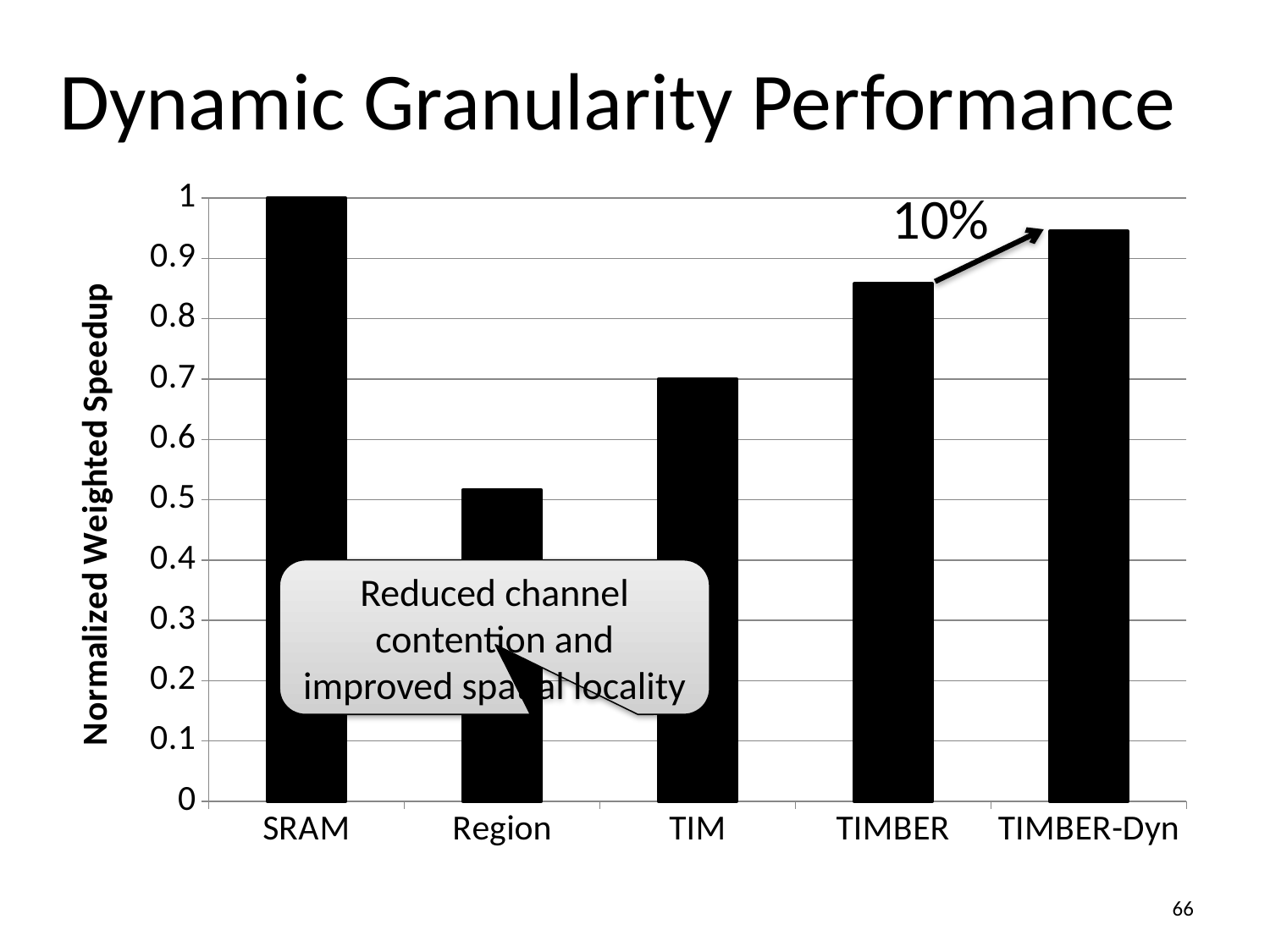
Which has a larger normalized weighted speedup, Region or TIMBER-Dyn? TIMBER-Dyn What kind of chart is shown on the slide? bar chart Is the value for TIM greater or less than 0.8? less Which has a larger normalized weighted speedup, TIMBER or TIM? TIMBER Which category has the lowest normalized weighted speedup? Region What is the normalized weighted speedup for SRAM? 1 How many categories are shown on the x axis of the chart? 5 Is the value for TIMBER greater or less than 0.8? greater Is the value for Region greater or less than 0.6? less What is the label of the y axis of the chart? Normalized Weighted Speedup Which category has the highest normalized weighted speedup? SRAM